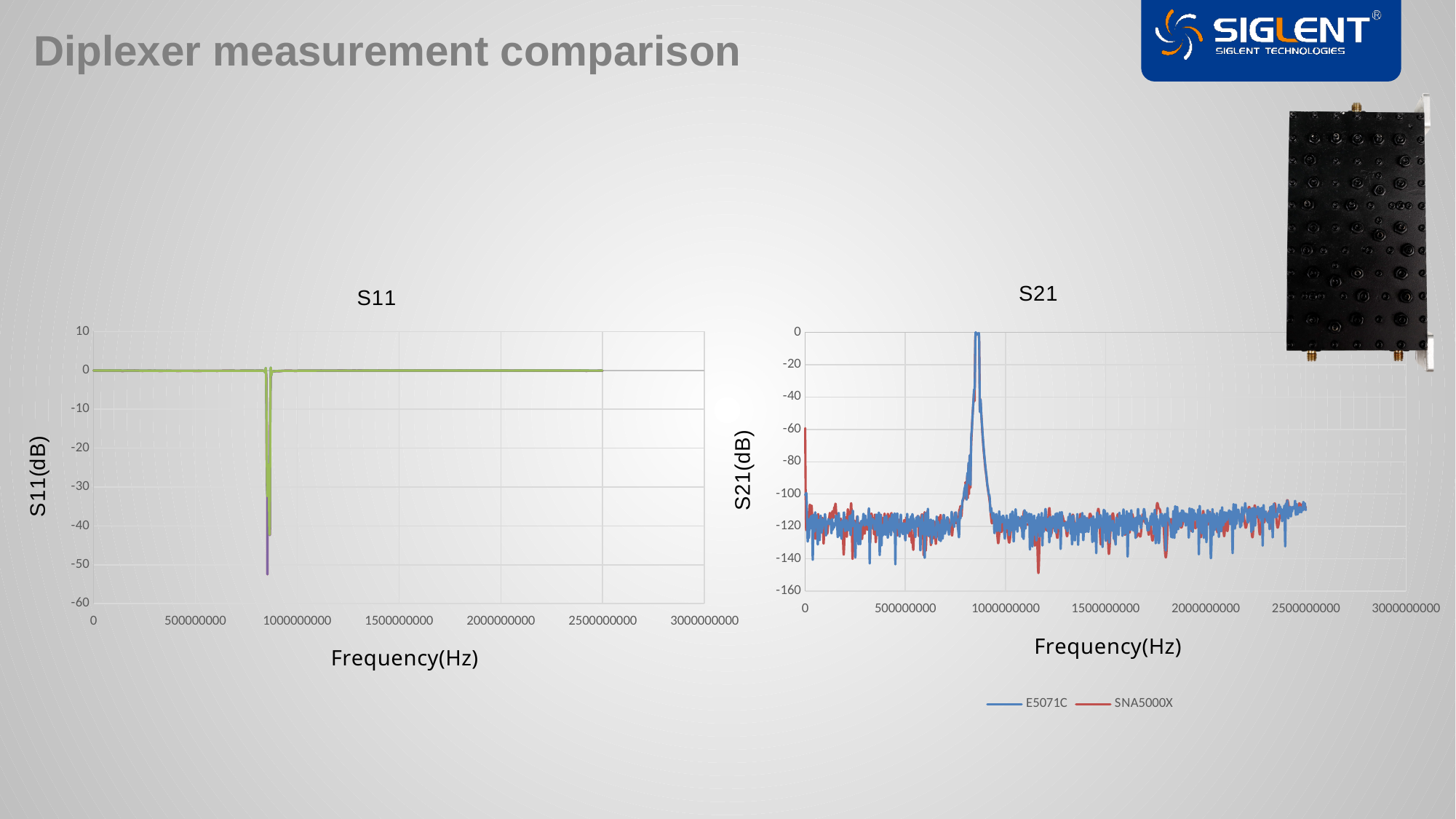
In the S11 chart, is the minimum value of the dip near 900000000 Hz greater or less than -40? less How many series does the legend of the S21 chart list? 2 In the S21 chart, is the peak value near 900000000 Hz greater or less than -20? greater In the S21 chart, is the value of the SNA5000X series at 2000000000 Hz greater or less than -60? less What is the lowest tick value shown on the y axis of the S21 chart? -160 What are the two series named in the legend of the S21 chart? E5071C and SNA5000X What kind of chart is the S21 chart? line chart In the S21 chart, which is larger: the value at 900000000 Hz or the value at 1500000000 Hz? 900000000 Hz What kind of chart is the S11 chart? line chart What is the label of the x axis on the S21 chart? Frequency(Hz)